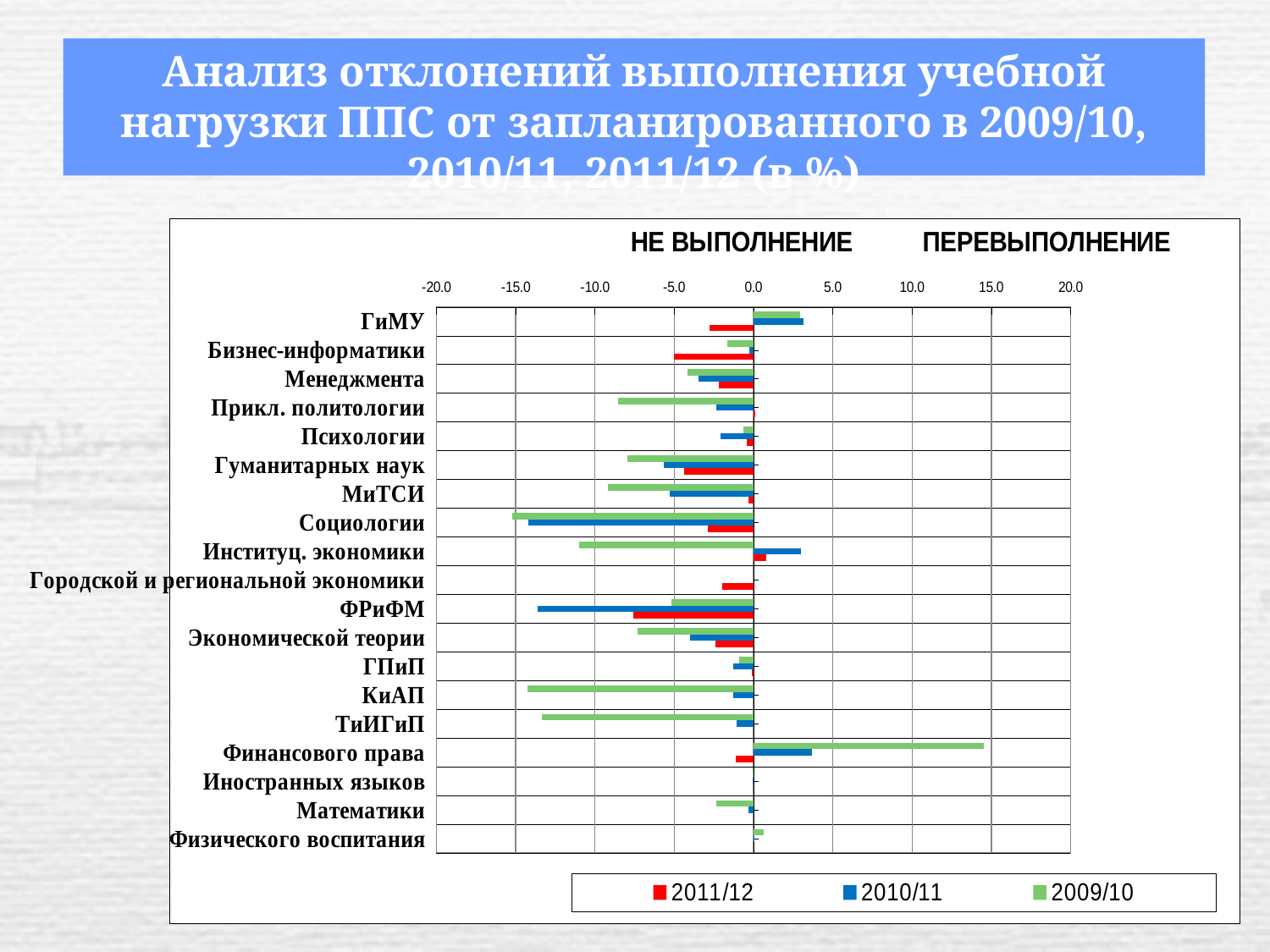
How many series does the legend list? 3 Which department has the highest 2009/10 value? Финансового права Which department has the lowest 2011/12 value? ФРиФМ Which department has the highest 2011/12 value? Институц. экономики For Финансового права, which is larger: the 2009/10 value or the 2010/11 value? 2009/10 Is the 2009/10 value for Финансового права greater or less than 10.0? greater Is the 2009/10 value for Социологии greater or less than -10.0? less Which series are listed in the legend? 2011/12, 2010/11, 2009/10 Is the 2010/11 value for ФРиФМ greater or less than -10.0? less What kind of chart is shown on the slide? Bar chart How many departments (categories) are plotted on the chart? 19 Which is larger: the 2009/10 value for КиАП or the 2009/10 value for ГПиП? ГПиП